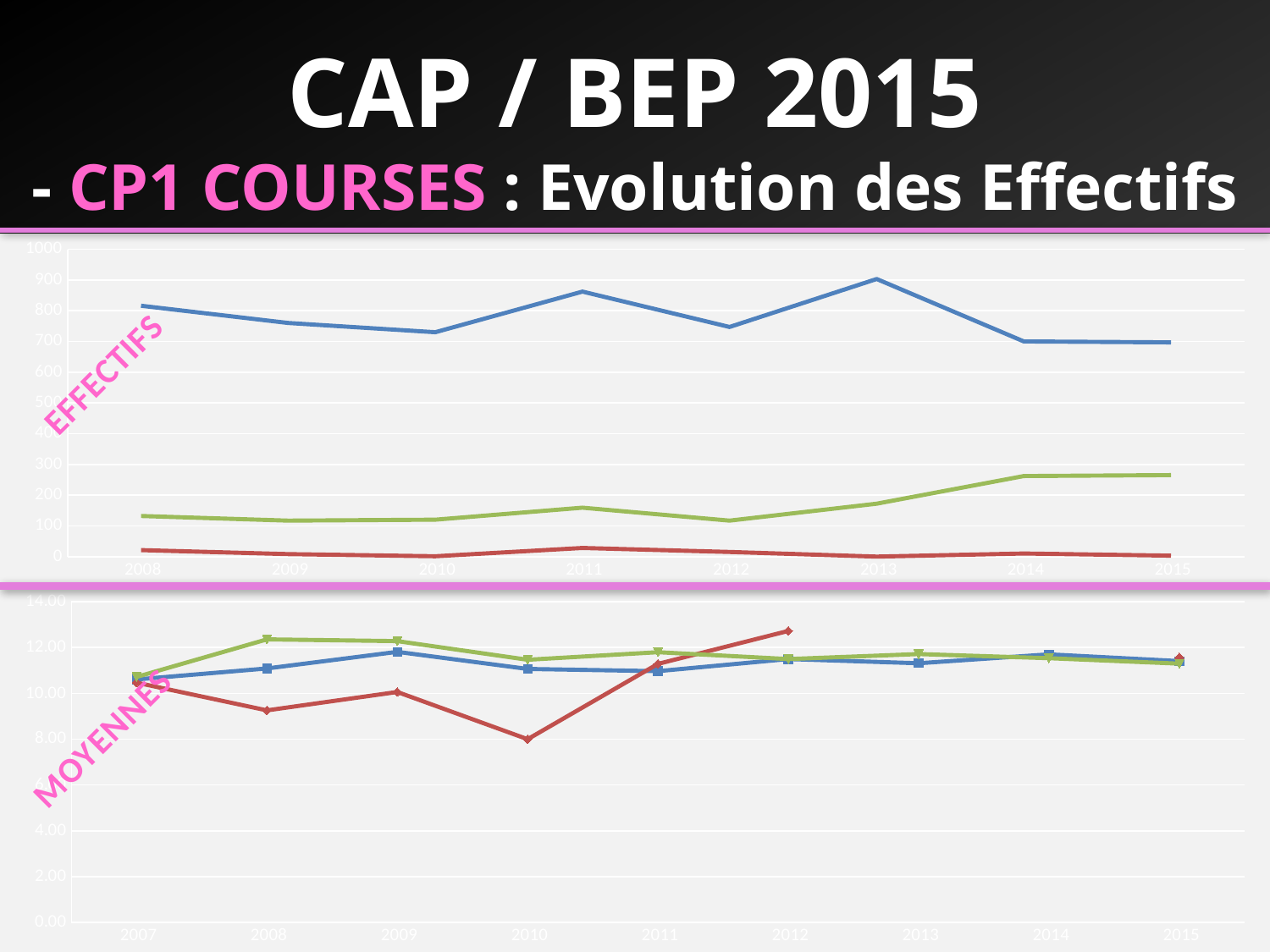
In the bottom chart (MOYENNES), is the value of the red line in 2010 greater or less than 10.00? less In the bottom chart (MOYENNES), in which year does the red line reach its lowest value? 2010 What kind of chart is the top chart labelled EFFECTIFS? line chart In the top chart (EFFECTIFS), is the value of the green line in 2015 greater or less than 200? greater In the top chart (EFFECTIFS), how many years are shown on the x axis? 8 In the top chart (EFFECTIFS), is the value of the blue line in 2013 greater or less than 800? greater In the top chart (EFFECTIFS), does the blue line rise or fall from 2013 to 2015? fall In the top chart (EFFECTIFS), how many lines are plotted? 3 In the bottom chart (MOYENNES), how many years are shown on the x axis? 9 In the top chart (EFFECTIFS), in which year does the blue line reach its highest value? 2013 In the top chart (EFFECTIFS), does the green line rise or fall from 2012 to 2015? rise In the bottom chart (MOYENNES), which line is higher in 2010, the green line or the red line? green line